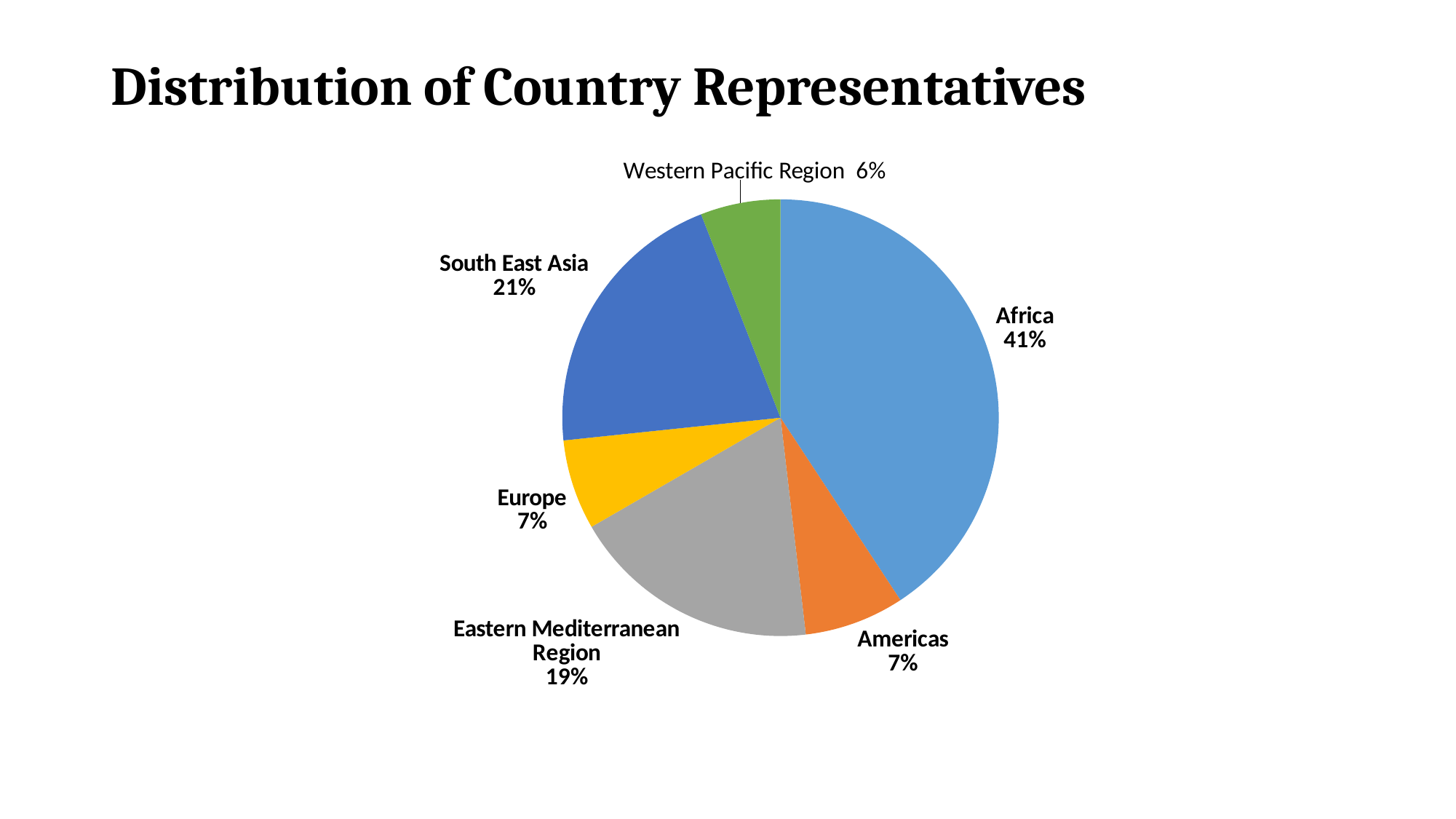
What share of country representatives is from the Eastern Mediterranean Region? 19% Which region has the largest share of country representatives? Africa What is the difference in percentage points between Africa's share and South East Asia's share? 20 Which has a larger share, South East Asia or the Eastern Mediterranean Region? South East Asia What share of country representatives is from Europe? 7% What share of country representatives is from Africa? 41% How many regions are shown in the pie chart? 6 Which region has the smallest share of country representatives? Western Pacific Region What is the title of the chart? Distribution of Country Representatives What kind of chart is shown on the slide? pie chart